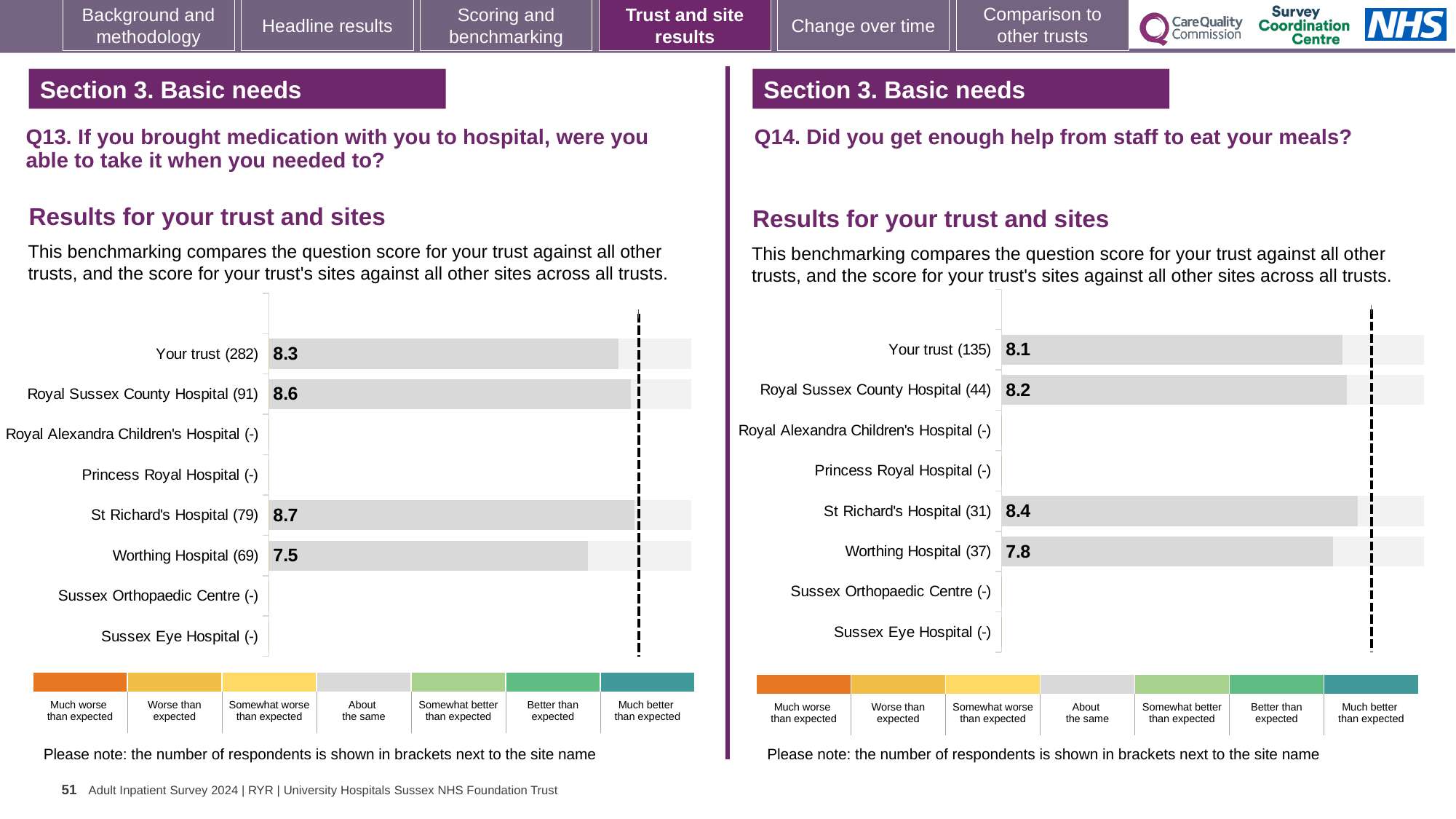
On the Q14 chart (right), what is the difference between the scores for Royal Sussex County Hospital and Your trust? 0.1 On the Q13 chart (left), which site has the lowest score? Worthing Hospital On the Q13 chart (left), what is the difference between the scores for St Richard's Hospital and Worthing Hospital? 1.2 On the Q14 chart (right), what is the score for Your trust (135)? 8.1 On the Q13 chart (left), how many categories in the colour key below the chart? 7 On the Q14 chart (right), what is the score for St Richard's Hospital (31)? 8.4 On the Q13 chart (left), which site has the highest score? St Richard's Hospital On the Q13 chart (left), how many site or trust categories are listed on the vertical axis? 8 On the Q14 chart (right), which is larger, the score for Royal Sussex County Hospital or Worthing Hospital? Royal Sussex County Hospital On the Q13 chart (left), what is the score for Your trust (282)? 8.3 On the Q13 chart (left), what is the score for Worthing Hospital (69)? 7.5 What kind of chart is used on the Q14 chart (right)? Bar chart